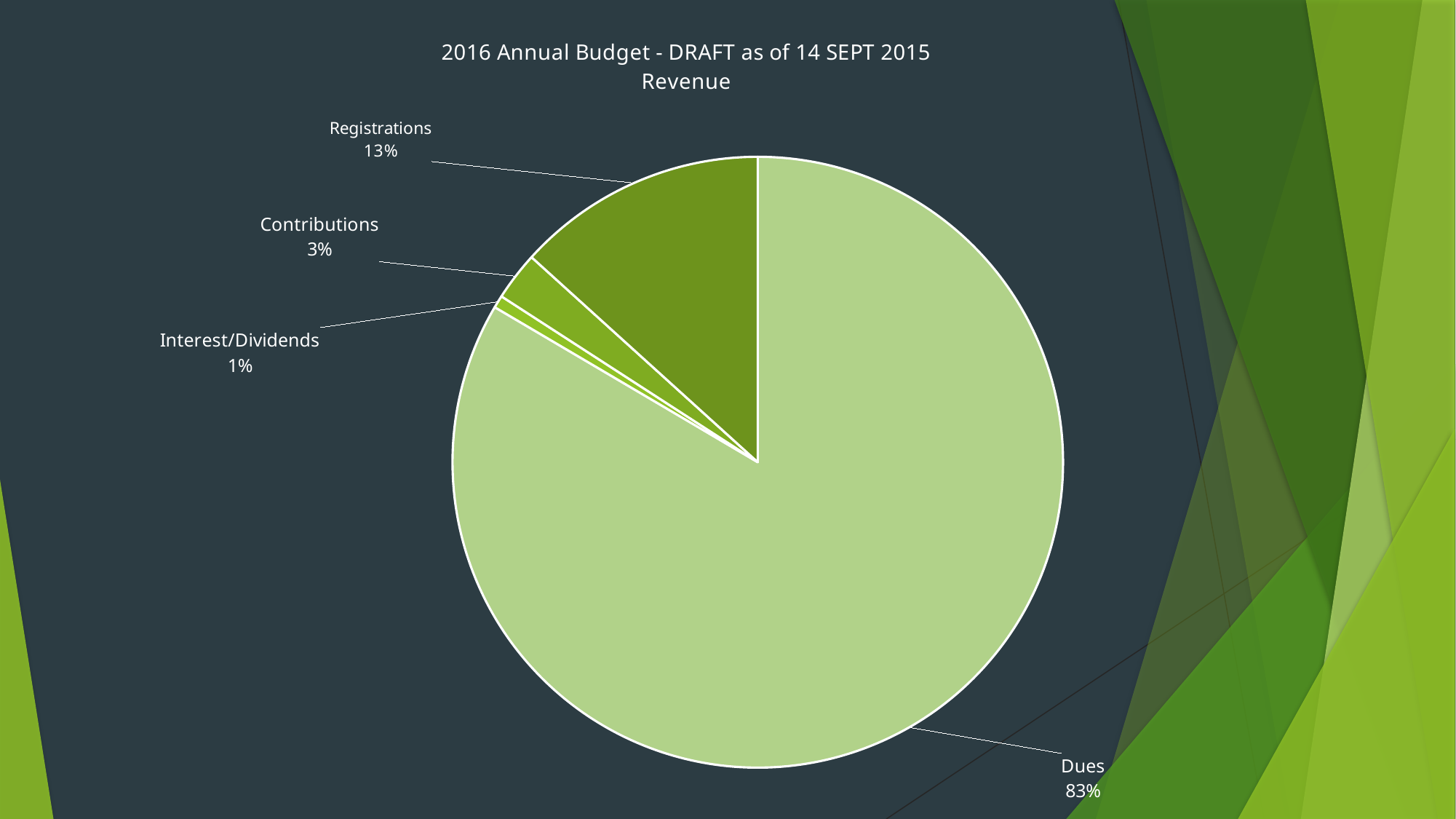
Which revenue category has the largest share? Dues What share of revenue comes from Contributions? 3% How many slices does the pie chart have? 4 What is the difference in percentage points between the Dues share and the Registrations share? 70 What share of revenue comes from Registrations? 13% What share of revenue comes from Dues? 83% What kind of chart is shown on the slide? pie chart Which is larger, the share for Registrations or the share for Contributions? Registrations What is the difference in percentage points between the Contributions share and the Interest/Dividends share? 2 Which revenue category has the smallest share? Interest/Dividends What is the title of the chart? 2016 Annual Budget - DRAFT as of 14 SEPT 2015 Revenue